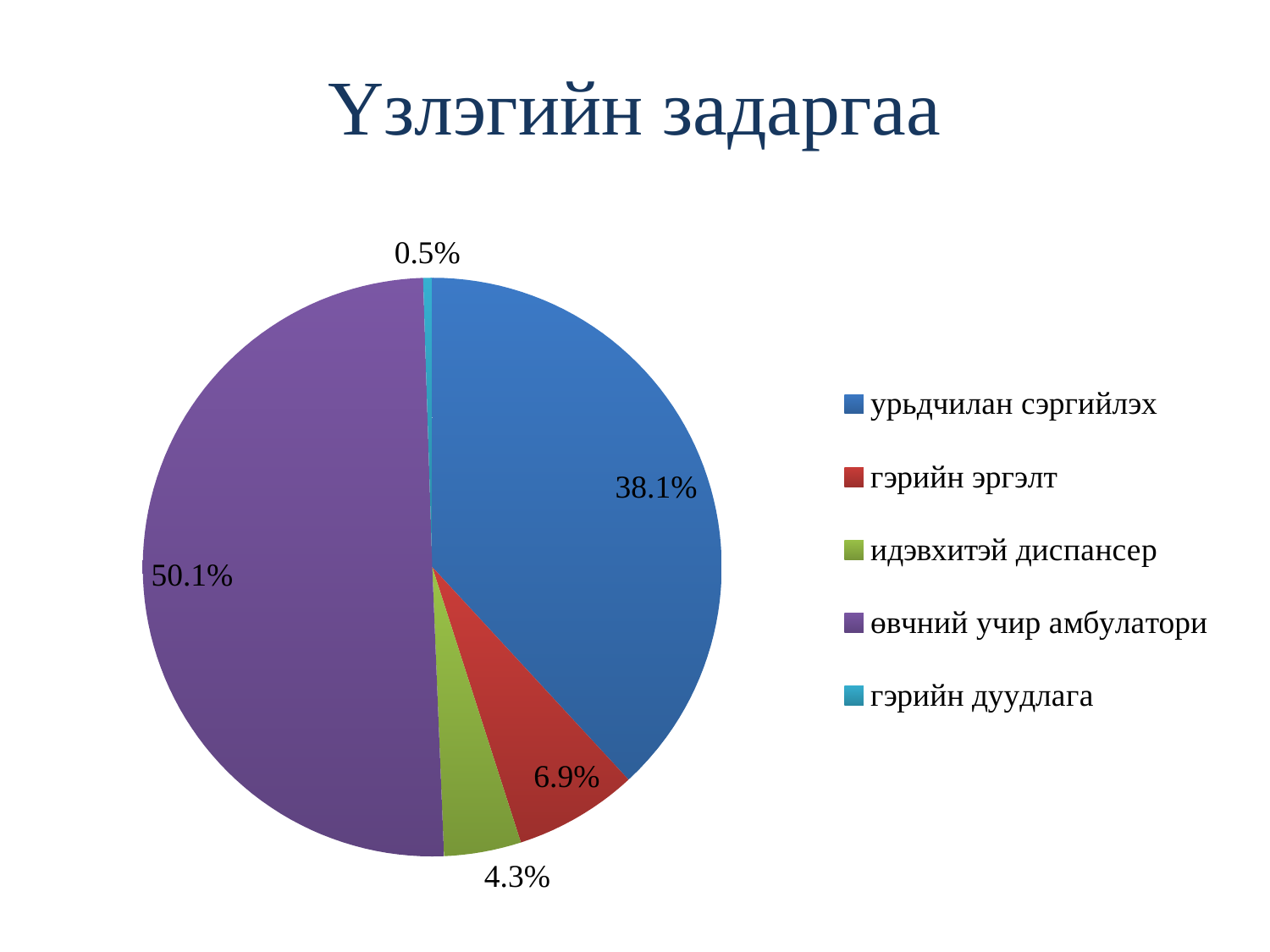
What is the difference between the shares of өвчний учир амбулатори and урьдчилан сэргийлэх? 12.0% How many categories does the legend list? 5 What kind of chart is shown on the slide? pie chart What share of the pie does гэрийн эргэлт have? 6.9% What is the title of the chart? Үзлэгийн задаргаа Which category has the largest slice of the pie? өвчний учир амбулатори What share of the pie does идэвхитэй диспансер have? 4.3% What share of the pie does өвчний учир амбулатори have? 50.1% What share of the pie does гэрийн дуудлага have? 0.5% Which category has the smallest slice of the pie? гэрийн дуудлага Which is larger, the share of гэрийн эргэлт or идэвхитэй диспансер? гэрийн эргэлт What share of the pie does урьдчилан сэргийлэх have? 38.1%